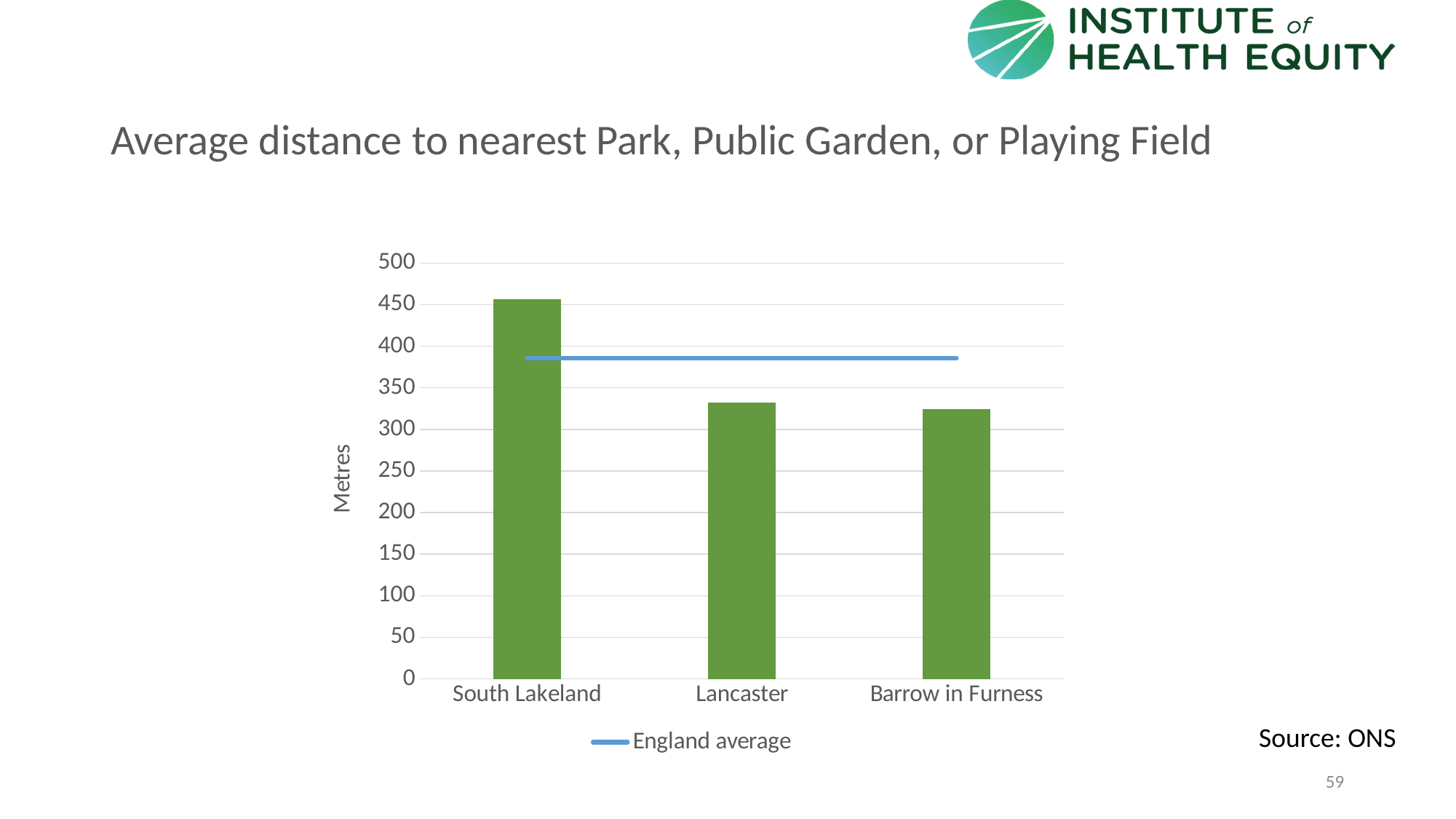
What unit is shown on the y axis label? Metres What entry does the legend list? England average Is the England average line greater or less than 400? less Is the value for South Lakeland above or below the England average line? above Is the value for Barrow in Furness greater or less than 300? greater Do the bar values rise or fall from left to right across the x axis? fall How many areas (categories) are plotted on the x axis? 3 Is the value for South Lakeland greater or less than 400? greater Which area has the highest average distance to the nearest park, public garden, or playing field? South Lakeland Which is larger, the value for South Lakeland or the value for Lancaster? South Lakeland What kind of chart is shown on the slide? Bar chart